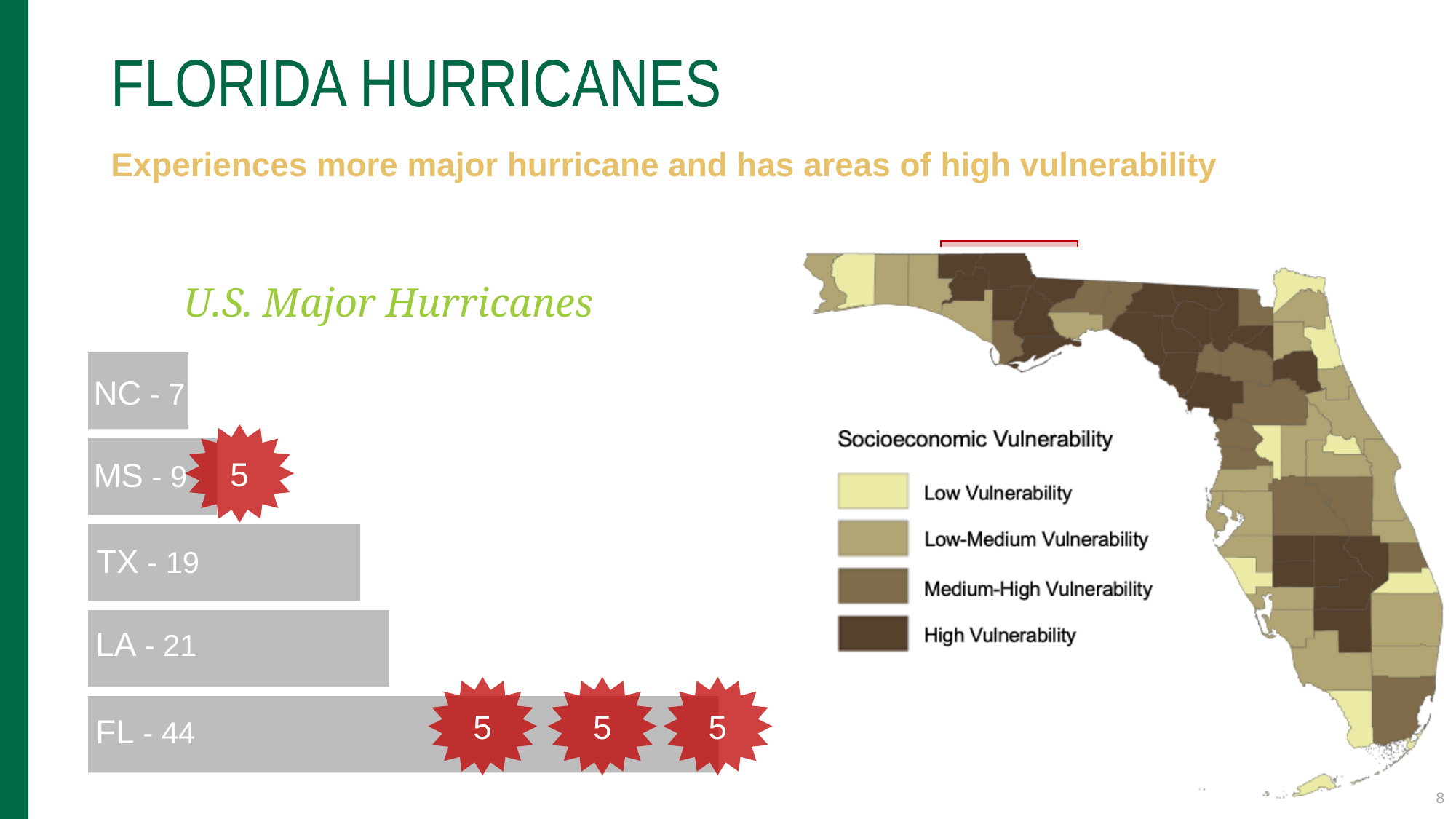
In the U.S. Major Hurricanes chart, what is the value for FL? 44 In the U.S. Major Hurricanes chart, what is the value for TX? 19 In the U.S. Major Hurricanes chart, what is the value for NC? 7 In the U.S. Major Hurricanes chart, what is the difference between the values for FL and LA? 23 What is the title of the chart on the left side of the slide? U.S. Major Hurricanes What kind of chart is the U.S. Major Hurricanes chart? bar chart In the U.S. Major Hurricanes chart, which state has the lowest value? NC In the U.S. Major Hurricanes chart, what is the difference between the values for TX and MS? 10 How many states are shown in the U.S. Major Hurricanes chart? 5 In the U.S. Major Hurricanes chart, what is the value for MS? 9 In the U.S. Major Hurricanes chart, which state has the highest value? FL In the U.S. Major Hurricanes chart, which is larger, the value for LA or the value for TX? LA